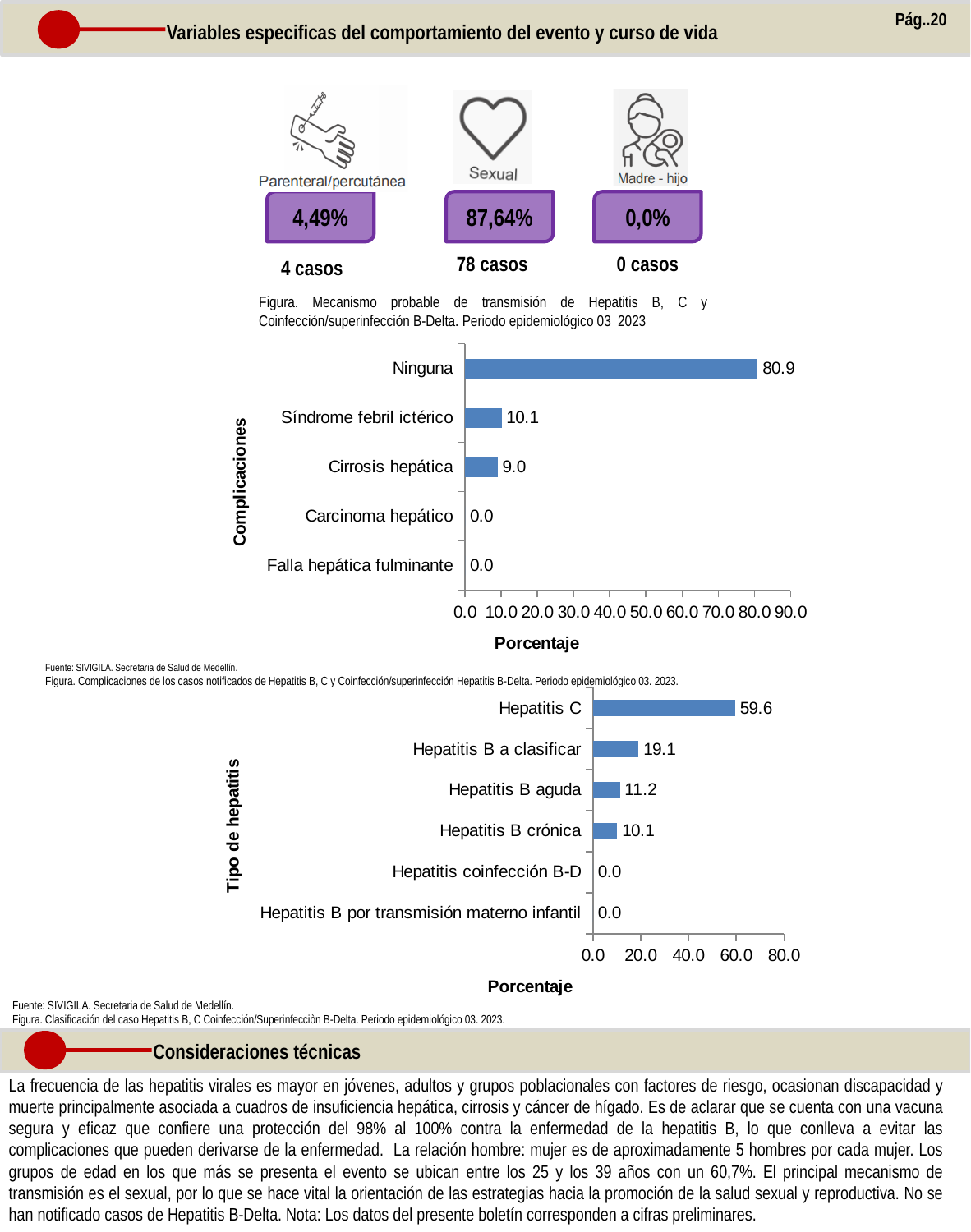
In the upper bar chart (Complicaciones), what is the percentage for Ninguna? 80.9 In the lower bar chart (Tipo de hepatitis), what is the percentage for Hepatitis C? 59.6 In the upper bar chart (Complicaciones), which complication has the highest percentage? Ninguna In the lower bar chart (Tipo de hepatitis), what is the difference between Hepatitis C and Hepatitis B a clasificar? 40.5 In the upper bar chart (Complicaciones), how many complication categories are shown? 5 In the upper bar chart (Complicaciones), what is the percentage for Cirrosis hepática? 9.0 In the lower bar chart (Tipo de hepatitis), how many hepatitis type categories are shown? 6 In the upper bar chart (Complicaciones), what is the label of the horizontal axis? Porcentaje What kind of chart is the lower chart (Tipo de hepatitis)? Bar chart In the upper bar chart (Complicaciones), what is the difference between Síndrome febril ictérico and Cirrosis hepática? 1.1 In the lower bar chart (Tipo de hepatitis), what is the percentage for Hepatitis B aguda? 11.2 In the lower bar chart (Tipo de hepatitis), which is larger, Hepatitis B a clasificar or Hepatitis B crónica? Hepatitis B a clasificar